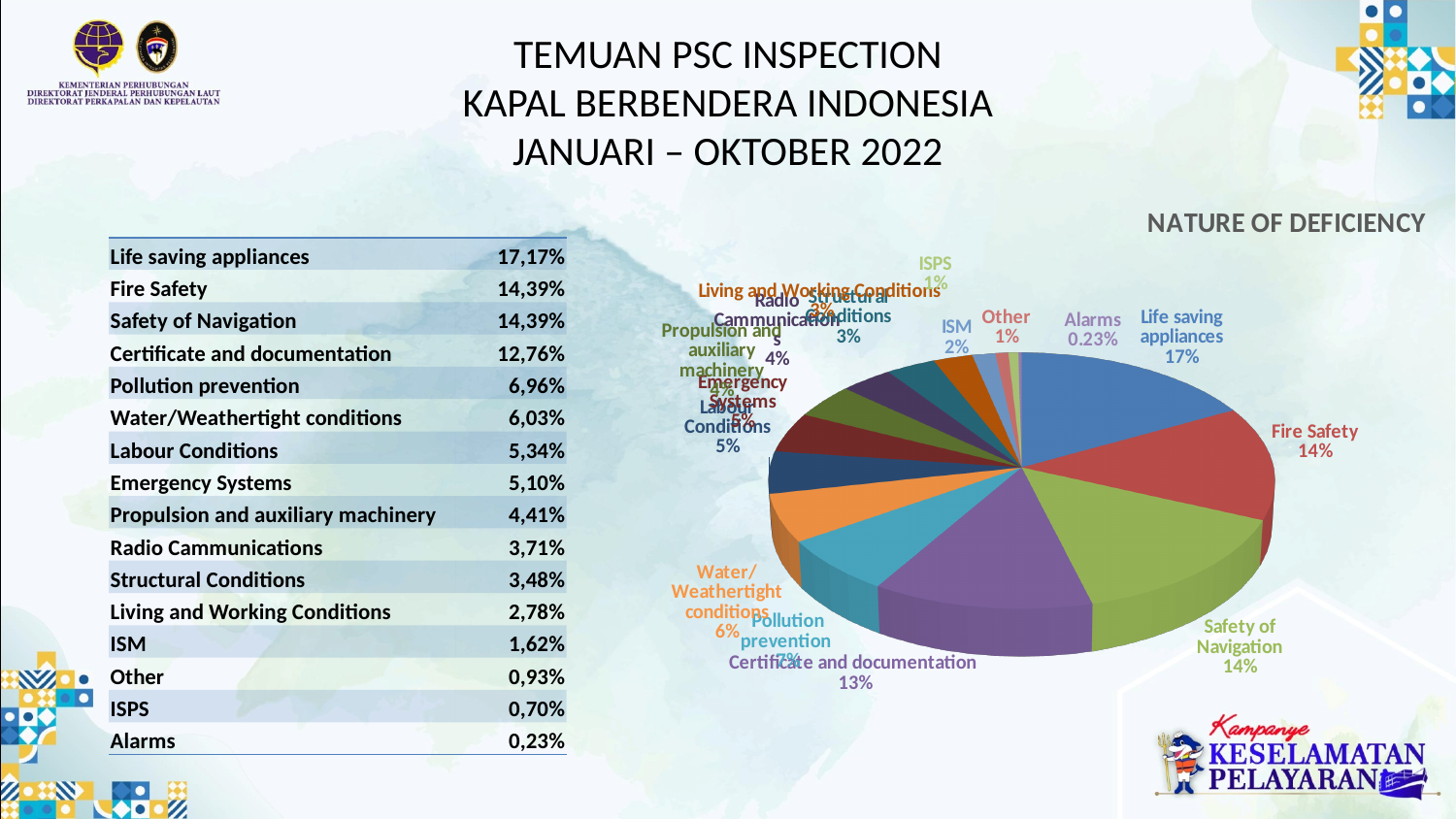
Which category has the smallest slice in the NATURE OF DEFICIENCY pie chart? Alarms In the NATURE OF DEFICIENCY pie chart, what share is labelled for Fire Safety? 14% What kind of chart is shown under the heading NATURE OF DEFICIENCY? Pie chart In the NATURE OF DEFICIENCY pie chart, what share is labelled for Water/Weathertight conditions? 6% In the NATURE OF DEFICIENCY pie chart, what share is labelled for Alarms? 0.23% In the NATURE OF DEFICIENCY pie chart, what share is labelled for Certificate and documentation? 13% In the NATURE OF DEFICIENCY pie chart, what share is labelled for Life saving appliances? 17% What is the title shown above the pie chart? NATURE OF DEFICIENCY In the NATURE OF DEFICIENCY pie chart, how many percentage points larger is the Life saving appliances share than the Fire Safety share? 3 percentage points Which category has the largest slice in the NATURE OF DEFICIENCY pie chart? Life saving appliances In the NATURE OF DEFICIENCY pie chart, what share is labelled for ISM? 2% In the NATURE OF DEFICIENCY pie chart, which slice is larger: Fire Safety or Certificate and documentation? Fire Safety